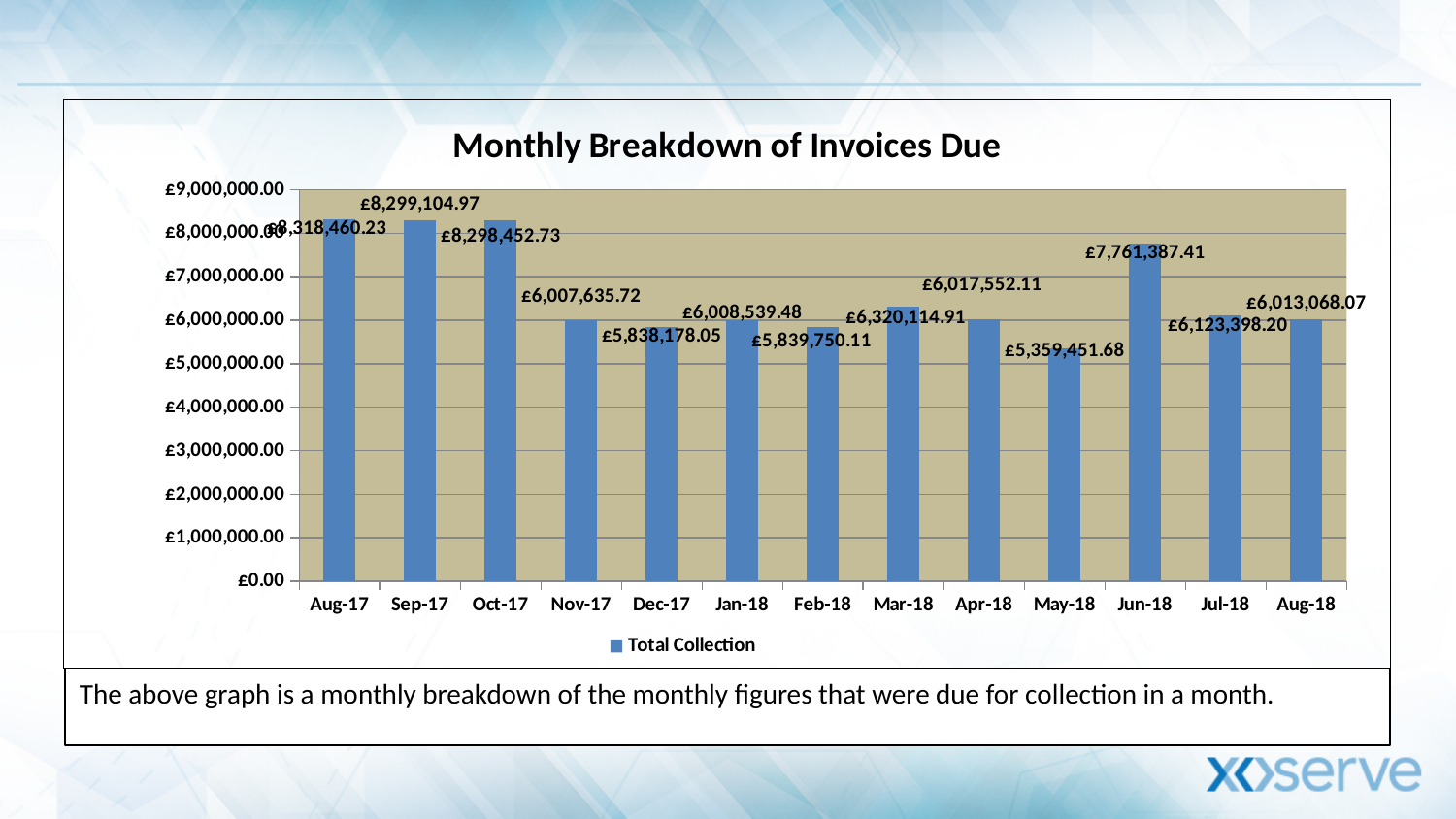
What is the difference between the values for Mar-18 and Apr-18? £302,562.80 What is the value for Mar-18? £6,320,114.91 Is the value for May-18 greater or less than £6,000,000.00? less Which is larger, the value for Jun-18 or the value for Jul-18? Jun-18 What is the value for May-18? £5,359,451.68 What is the value for Jun-18? £7,761,387.41 What kind of chart is shown? bar chart What is the value for Sep-17? £8,299,104.97 What is the title of the chart? Monthly Breakdown of Invoices Due Which month has the lowest value? May-18 What is the difference between the values for Jun-18 and May-18? £2,401,935.73 How many months are shown on the x axis? 13